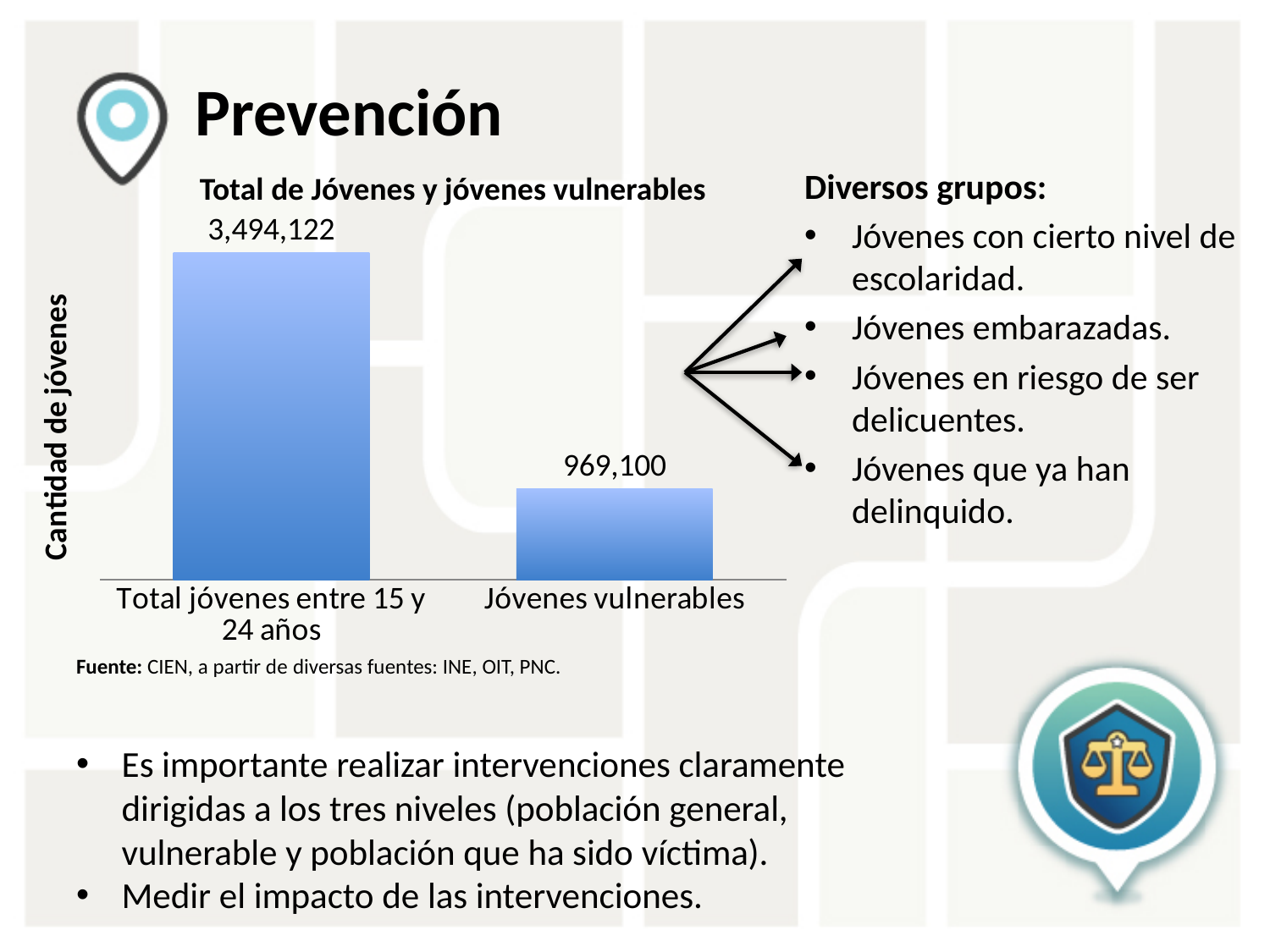
What is the value for 'Jóvenes vulnerables'? 969,100 What is the title of the chart? Total de Jóvenes y jóvenes vulnerables Which category has the lowest value? Jóvenes vulnerables What is the value for 'Total jóvenes entre 15 y 24 años'? 3,494,122 Which category has the highest value? Total jóvenes entre 15 y 24 años What is the label of the vertical axis of the chart? Cantidad de jóvenes How many categories are shown in the chart? 2 What kind of chart is shown on the slide? Bar chart What is the difference between the value for 'Total jóvenes entre 15 y 24 años' and the value for 'Jóvenes vulnerables'? 2,525,022 Do the values rise or fall from left to right along the x axis? Fall Which is larger, the value for 'Total jóvenes entre 15 y 24 años' or the value for 'Jóvenes vulnerables'? Total jóvenes entre 15 y 24 años